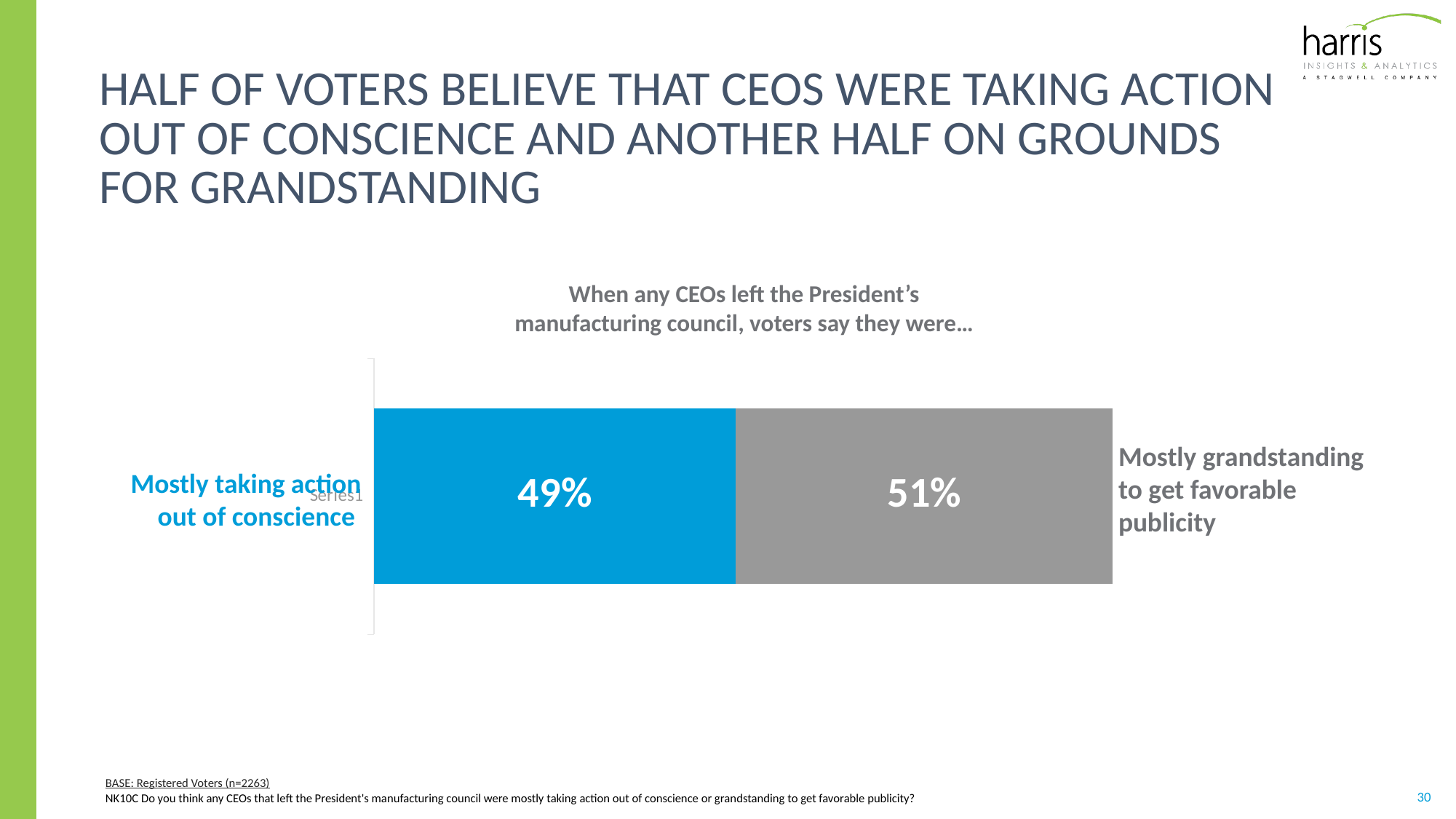
Which segment is the smallest in the bar? Mostly taking action out of conscience (49%) What is the title of the chart? When any CEOs left the President's manufacturing council, voters say they were... What percentage of voters say CEOs were mostly grandstanding to get favorable publicity? 51% What is the difference in percentage points between the grandstanding share and the conscience share? 2 percentage points What is the total of the two segments in the stacked bar? 100% How many segments does the bar contain? 2 Which response has the larger share: mostly taking action out of conscience or mostly grandstanding to get favorable publicity? Mostly grandstanding to get favorable publicity What colour is the segment for 'Mostly taking action out of conscience'? Blue What percentage of voters say CEOs were mostly taking action out of conscience? 49% What kind of chart is shown on the slide? Stacked horizontal bar chart Which segment is the largest in the bar? Mostly grandstanding to get favorable publicity (51%)